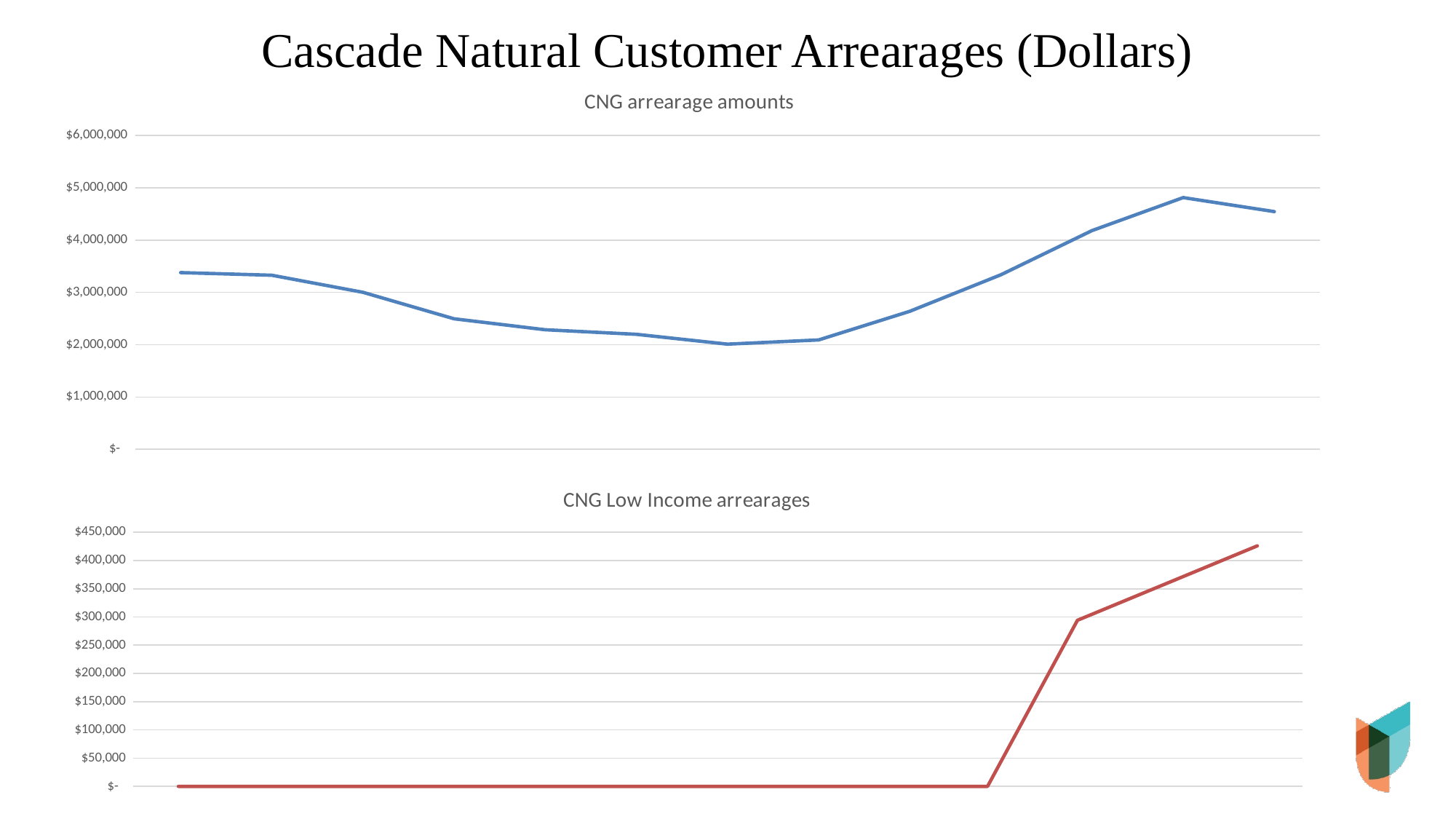
In the "CNG arrearage amounts" chart, does the line end higher or lower than it starts? higher In the "CNG arrearage amounts" chart, is the lowest point on the line greater or less than $3,000,000? less In the "CNG arrearage amounts" chart, is the last point on the line greater or less than $4,000,000? greater How many charts are shown on the slide? 2 In the "CNG arrearage amounts" chart, is the first point on the line greater or less than $3,000,000? greater In the "CNG Low Income arrearages" chart, does the line rise or fall over its final points? rise In the "CNG Low Income arrearages" chart, what value does the line sit at for the first part of the series? $- What kind of chart is the "CNG Low Income arrearages" chart? line chart What colour is the line in the "CNG Low Income arrearages" chart? red What kind of chart is the "CNG arrearage amounts" chart? line chart